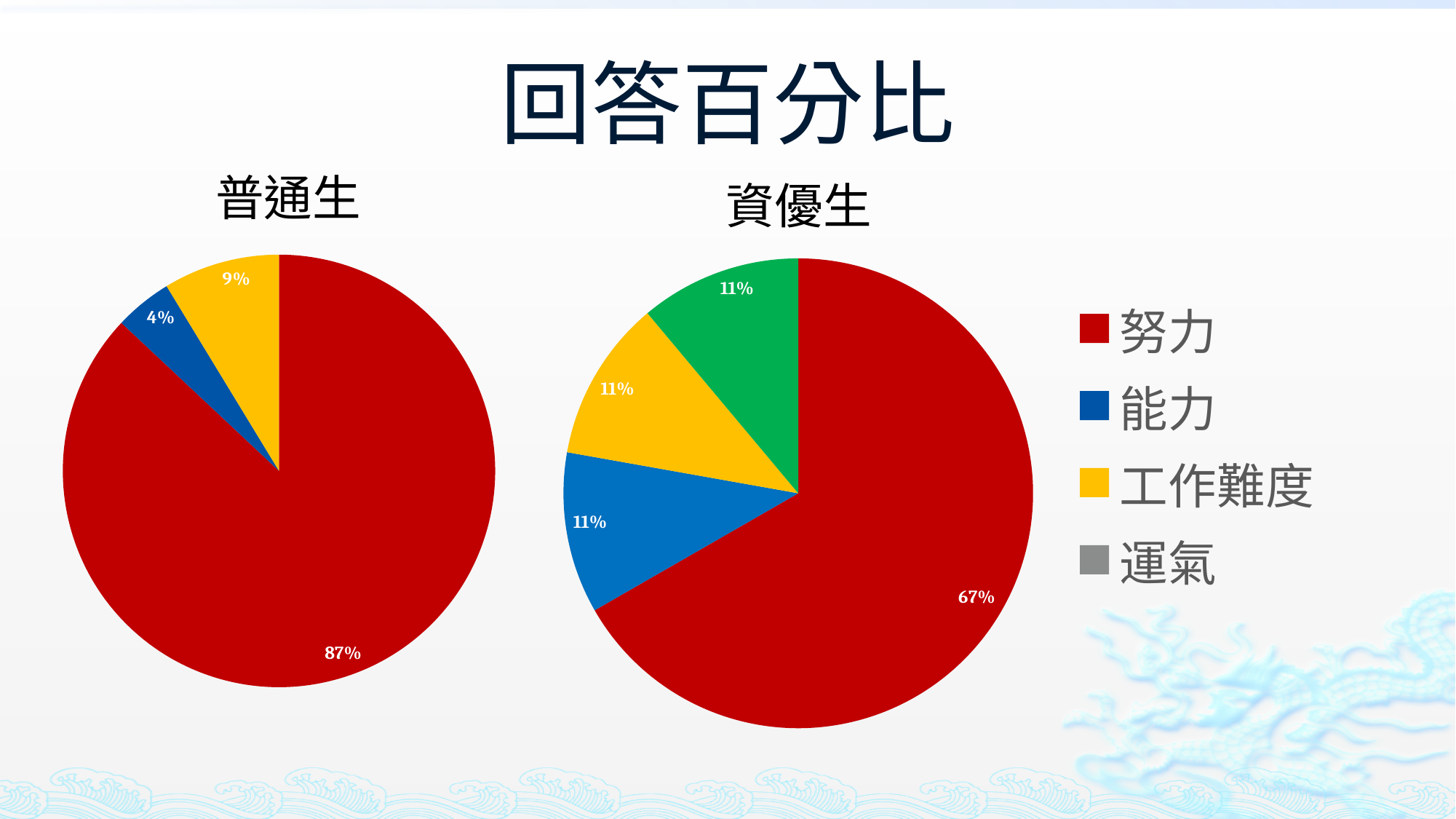
In the 資優生 pie chart, what percentage is shown for 努力? 67% In the 普通生 pie chart, which category has the smallest slice? 能力 In the 資優生 pie chart, what percentage is shown for 能力? 11% By how many percentage points is the 努力 share in the 普通生 chart larger than in the 資優生 chart? 20 percentage points In the 普通生 pie chart, which category has the largest slice? 努力 In the 普通生 pie chart, what percentage is shown for 能力? 4% Is the 工作難度 share larger in the 普通生 chart or the 資優生 chart? 資優生 How many slices does the 普通生 pie chart have? 3 In the 普通生 pie chart, what percentage is shown for 努力? 87% In the 資優生 pie chart, which category has the largest slice? 努力 How many entries does the legend on the slide list? 4 In the 普通生 pie chart, what percentage is shown for 工作難度? 9%